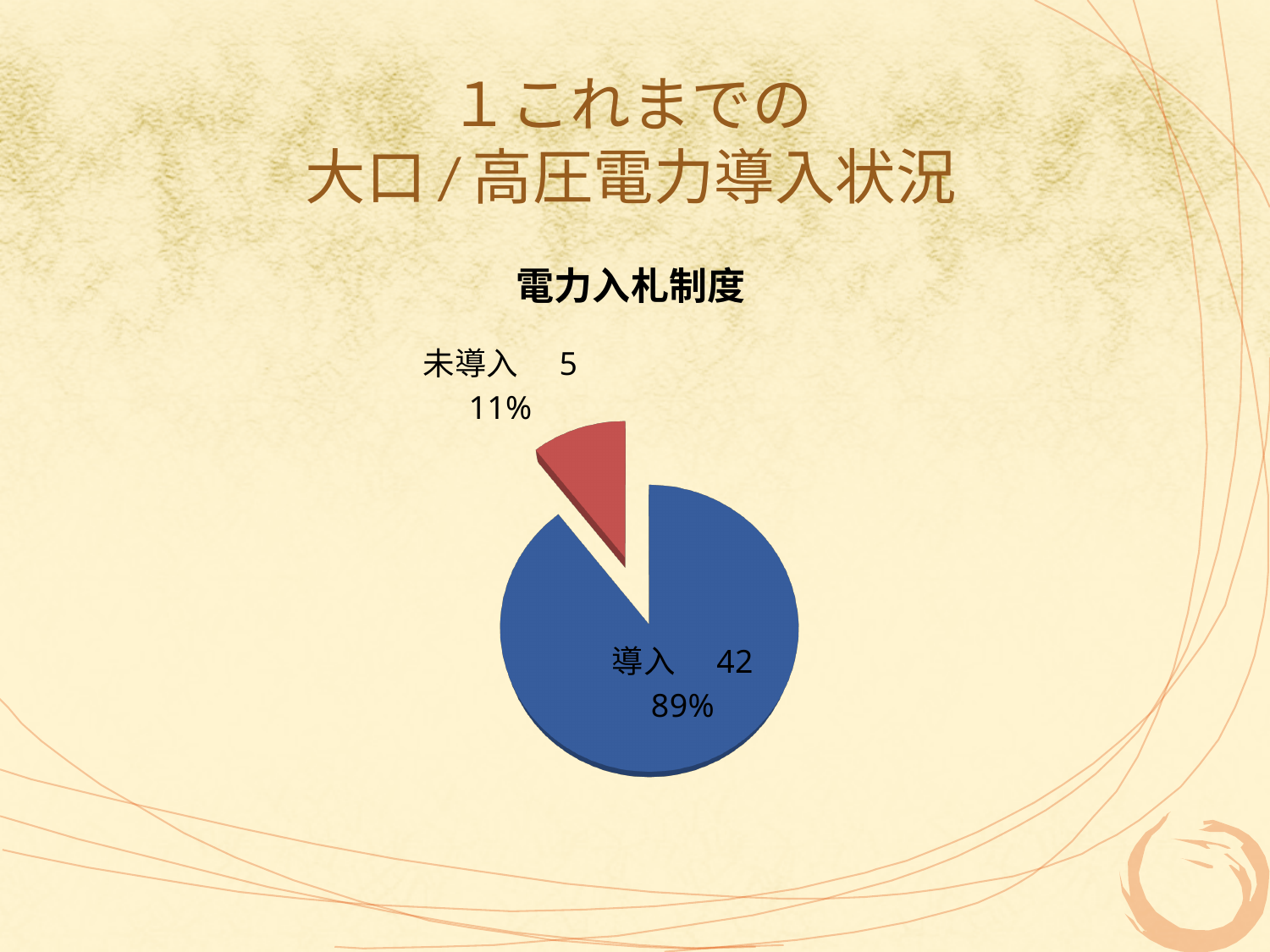
Which category has the smallest slice? 未導入 What is the difference between the values for 導入 and 未導入? 37 Which is larger, 導入 or 未導入? 導入 What colour is the 未導入 slice? red How many categories are shown in the pie chart? 2 What kind of chart is shown on the slide? pie chart What is the title of the chart? 電力入札制度 What share of the pie does 導入 represent? 89% Which category has the largest slice? 導入 What is the value for 未導入? 5 What is the value for 導入? 42 What share of the pie does 未導入 represent? 11%